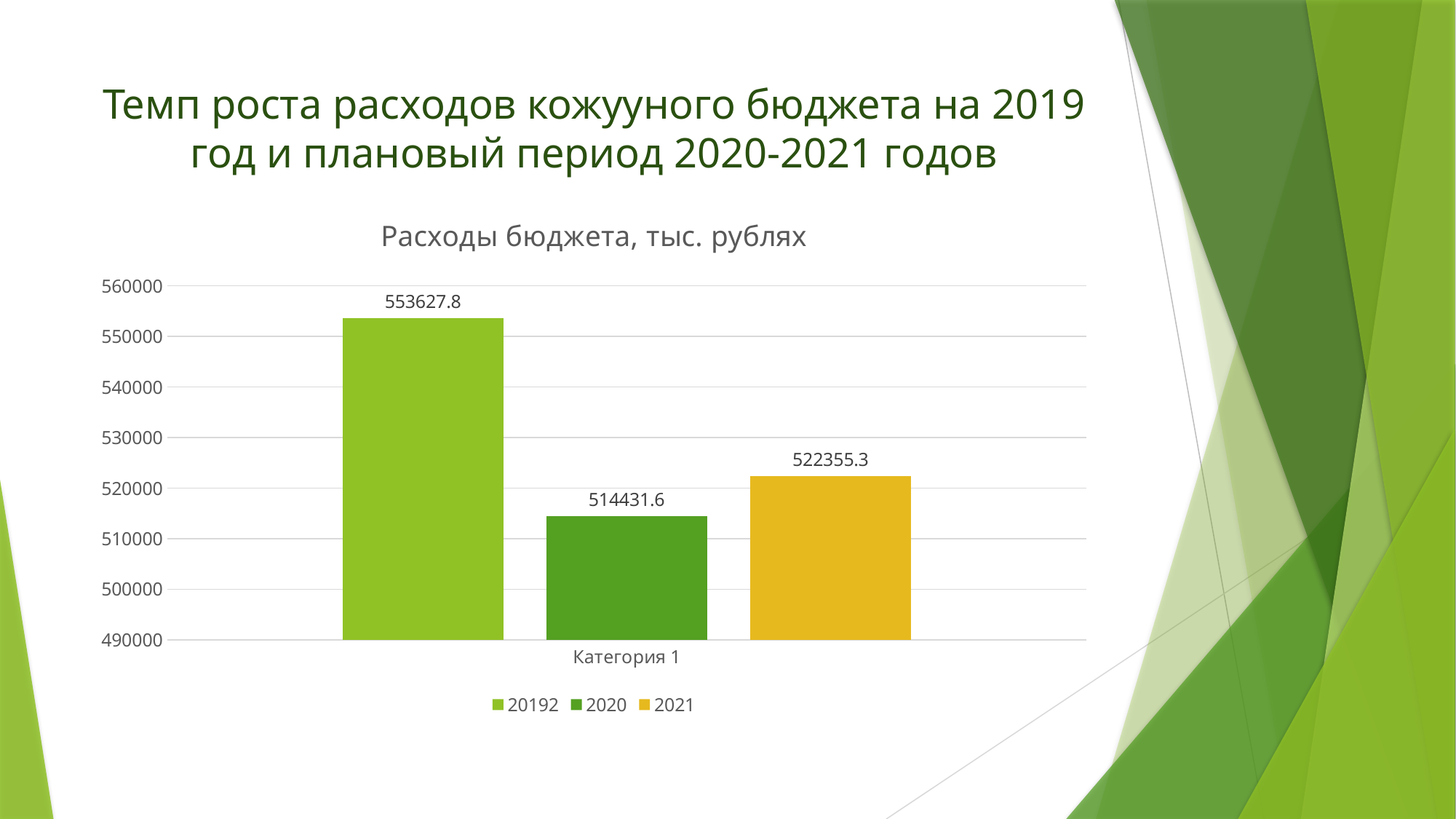
What kind of chart is shown on the slide? bar chart What is the difference between the 20192 value and the 2020 value? 39196.2 What is the value of the 2021 series in the chart? 522355.3 Which series has the highest value in the chart? 20192 What is the value of the 20192 series in the chart? 553627.8 What is the value of the 2020 series in the chart? 514431.6 How many series does the legend list? 3 What is the difference between the 2021 value and the 2020 value? 7923.7 Which is larger, the value for 2020 or the value for 2021? 2021 What is the title of the chart? Расходы бюджета, тыс. рублях Which series has the lowest value in the chart? 2020 Is the value for 2021 greater or less than 530000? less